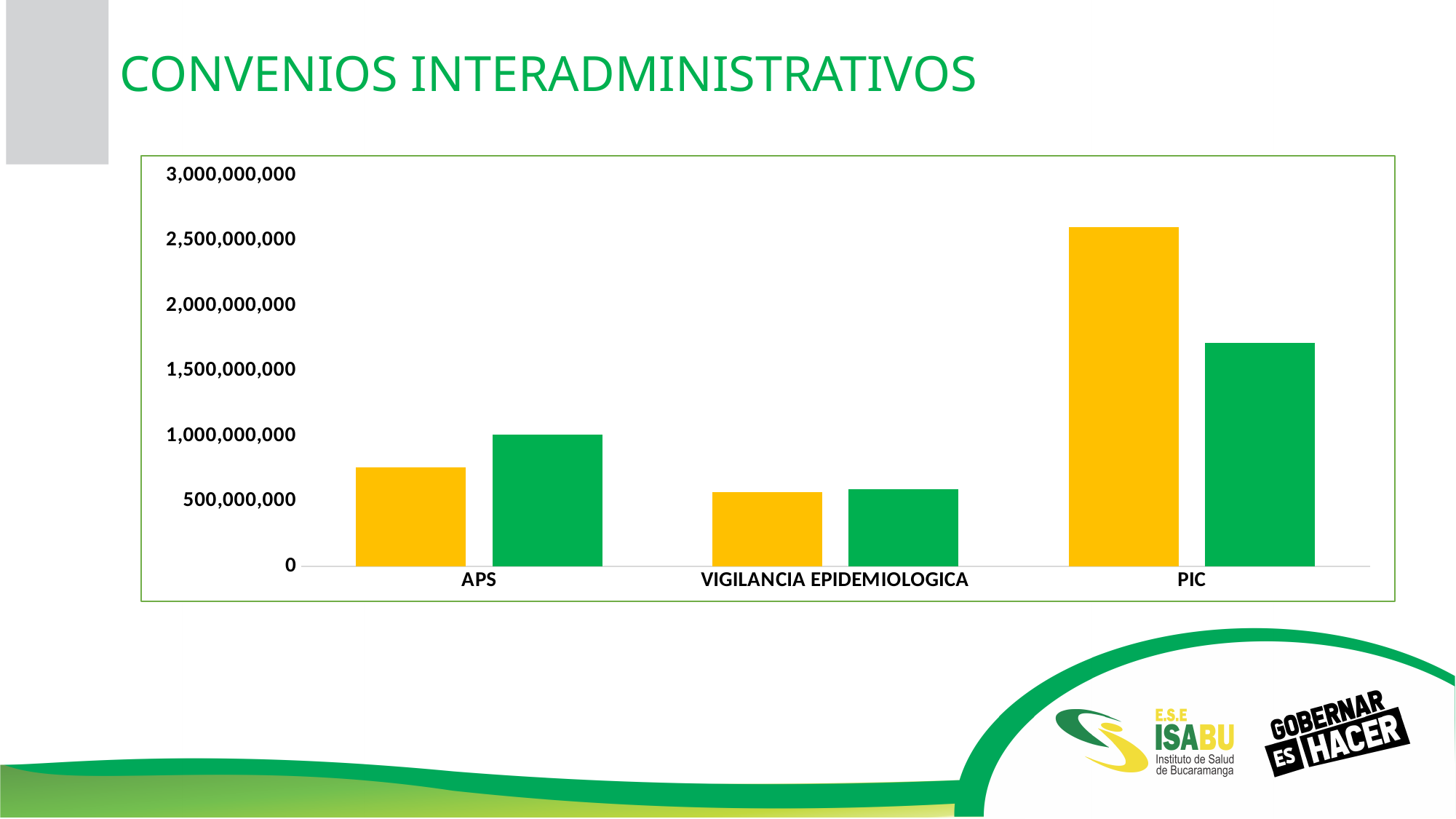
What type of chart is shown on the slide? bar chart How many bars are plotted for each category in the chart? 2 For PIC, which bar is taller, the yellow bar or the green bar? yellow Is the value of the yellow bar for PIC greater or less than 2,500,000,000? greater Which category has the lowest yellow bar in the chart? VIGILANCIA EPIDEMIOLOGICA For APS, which bar is taller, the yellow bar or the green bar? green Which category has the tallest bar in the chart? PIC What is the title of the slide containing the chart? CONVENIOS INTERADMINISTRATIVOS Is the value of the yellow bar for APS greater or less than 1,000,000,000? less Which category has the lowest green bar in the chart? VIGILANCIA EPIDEMIOLOGICA Is the value of the green bar for PIC greater or less than 2,000,000,000? less How many categories are shown on the x axis of the chart? 3